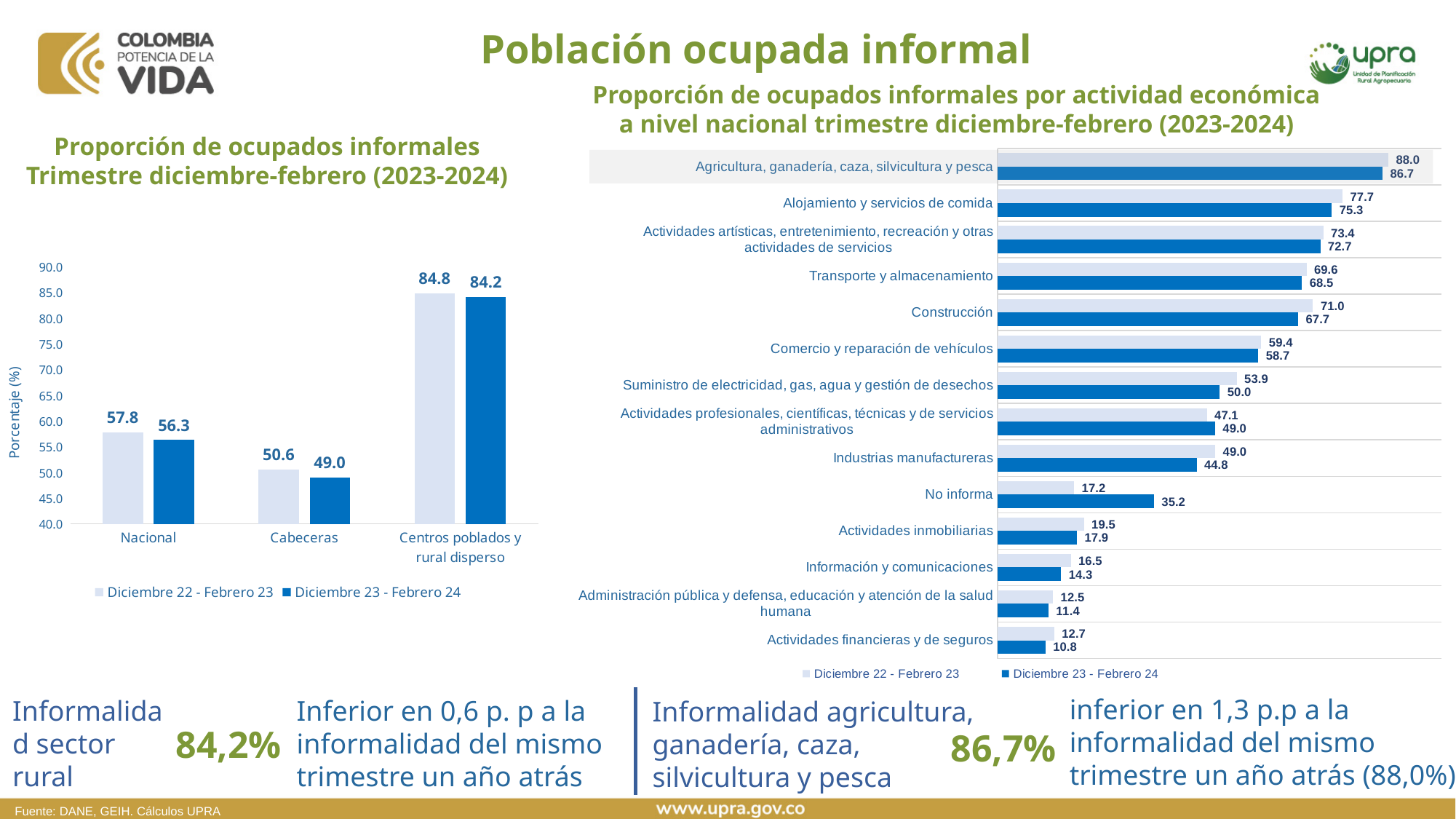
In the left chart (Proporción de ocupados informales Trimestre diciembre-febrero), which category has the highest value in Diciembre 23 - Febrero 24? Centros poblados y rural disperso In the left chart (Proporción de ocupados informales Trimestre diciembre-febrero), what is the value for Nacional in Diciembre 23 - Febrero 24? 56.3 In the right chart (Proporción de ocupados informales por actividad económica), what is the value for Construcción in Diciembre 23 - Febrero 24? 67.7 In the left chart (Proporción de ocupados informales Trimestre diciembre-febrero), what is the difference between the Diciembre 22 - Febrero 23 and Diciembre 23 - Febrero 24 values for Nacional? 1.5 In the right chart (Proporción de ocupados informales por actividad económica), what is the value for No informa in Diciembre 22 - Febrero 23? 17.2 In the right chart (Proporción de ocupados informales por actividad económica), which is larger for Industrias manufactureras: the Diciembre 22 - Febrero 23 value or the Diciembre 23 - Febrero 24 value? Diciembre 22 - Febrero 23 In the left chart (Proporción de ocupados informales Trimestre diciembre-febrero), what is the value for Cabeceras in Diciembre 22 - Febrero 23? 50.6 In the right chart (Proporción de ocupados informales por actividad económica), what is the difference between the Diciembre 22 - Febrero 23 and Diciembre 23 - Febrero 24 values for Agricultura, ganadería, caza, silvicultura y pesca? 1.3 In the right chart (Proporción de ocupados informales por actividad económica), how many economic activities are listed? 14 In the right chart (Proporción de ocupados informales por actividad económica), which activity has the lowest value in Diciembre 23 - Febrero 24? Actividades financieras y de seguros What kind of chart is the left chart (Proporción de ocupados informales Trimestre diciembre-febrero)? Bar chart In the left chart (Proporción de ocupados informales Trimestre diciembre-febrero), how many series does the legend list? 2